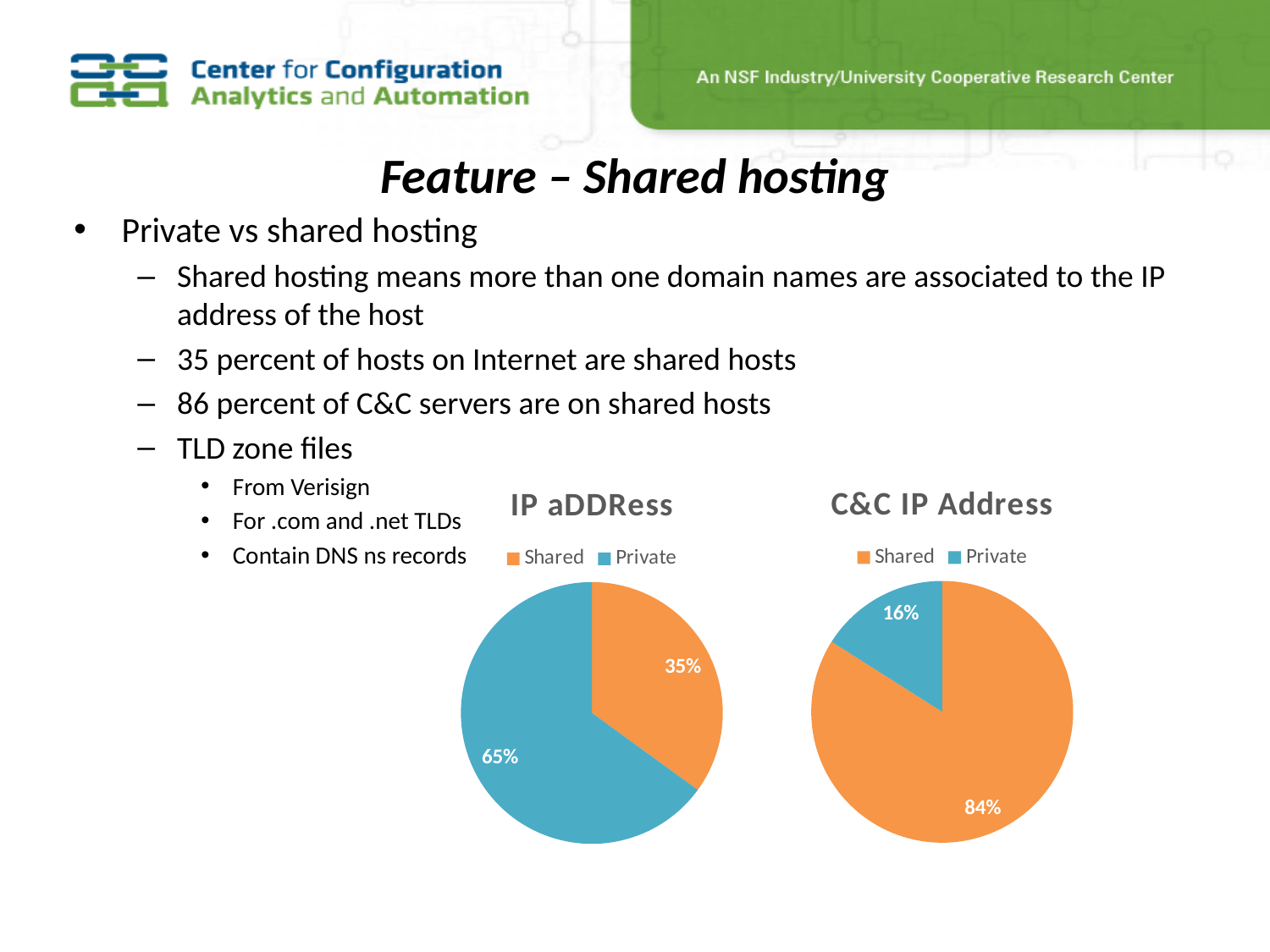
In the "C&C IP Address" chart, what share is labelled for Private? 16% Is the Shared share larger in the "IP aDDRess" chart or in the "C&C IP Address" chart? C&C IP Address In the "C&C IP Address" chart, what is the difference between the Shared and Private shares? 68% In the "IP aDDRess" chart, which slice is the largest? Private In the "IP aDDRess" chart, what share is labelled for Private? 65% In the "IP aDDRess" chart, what is the difference between the Private and Shared shares? 30% In the "IP aDDRess" chart, what share is labelled for Shared? 35% In the "C&C IP Address" chart, what share is labelled for Shared? 84% In the "C&C IP Address" chart, what colour is the Shared slice? Orange What type of chart is the "C&C IP Address" chart? Pie chart In the "C&C IP Address" chart, which slice is the smallest? Private How many slices does the "IP aDDRess" pie chart have? 2